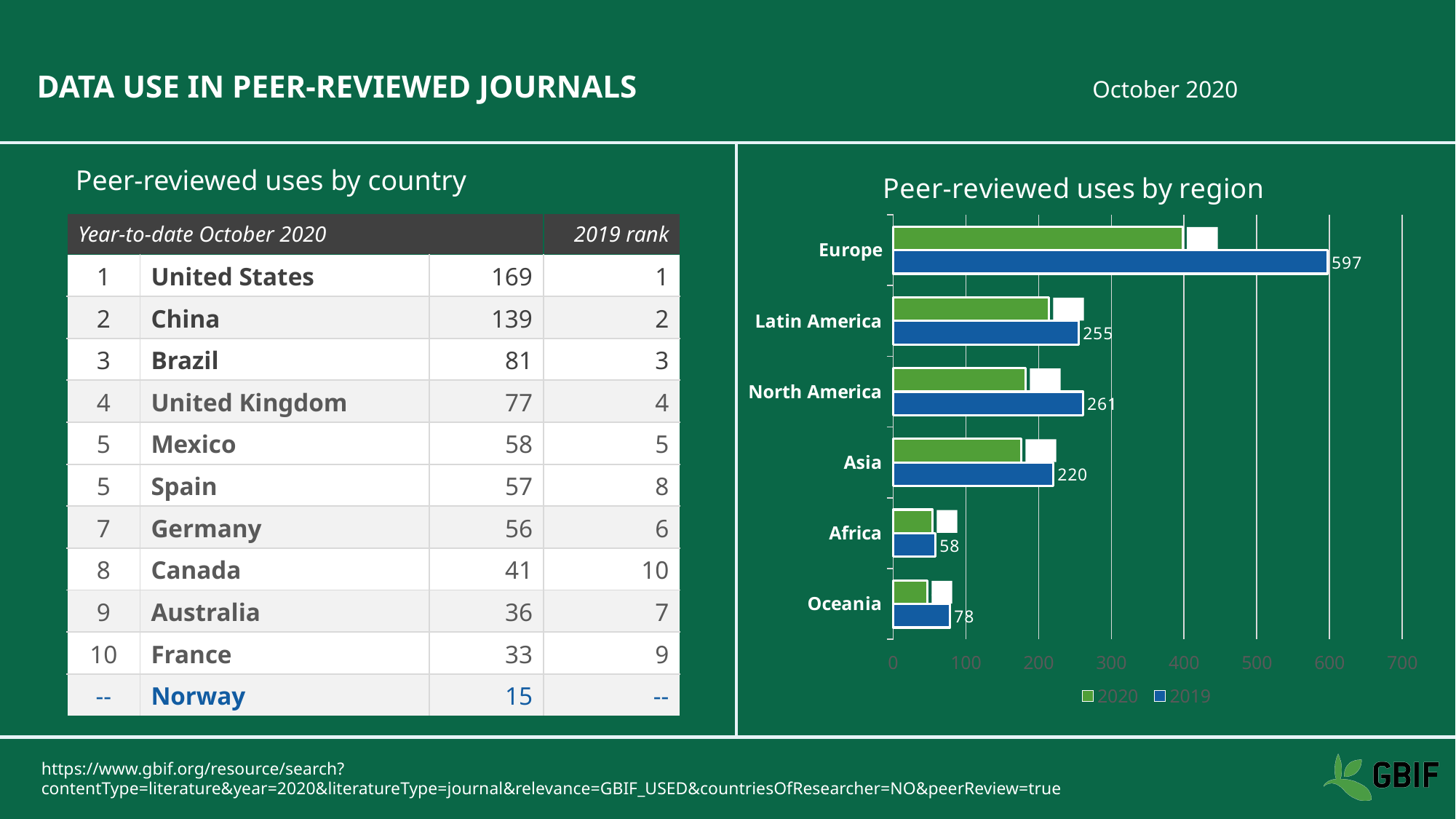
In the 'Peer-reviewed uses by region' chart, is the 2020 value for Europe greater or less than 300? greater How many series does the legend of the 'Peer-reviewed uses by region' chart list? 2 In the 'Peer-reviewed uses by region' chart, which region has the highest 2019 value? Europe In the 'Peer-reviewed uses by region' chart, which has the larger 2019 value, Oceania or Africa? Oceania In the 'Peer-reviewed uses by region' chart, which region has the lowest 2019 value? Africa In the 'Peer-reviewed uses by region' chart, is the 2020 value for Africa greater or less than 100? less How many regions are shown in the 'Peer-reviewed uses by region' chart? 6 In the 'Peer-reviewed uses by region' chart, what is the difference between the 2019 values for North America and Latin America? 6 In the 'Peer-reviewed uses by region' chart, what is the 2019 value for Europe? 597 In the 'Peer-reviewed uses by region' chart, what is the 2019 value for Latin America? 255 In the 'Peer-reviewed uses by region' chart, what is the difference between the 2019 values for Europe and Asia? 377 In the 'Peer-reviewed uses by region' chart, what is the 2019 value for Africa? 58